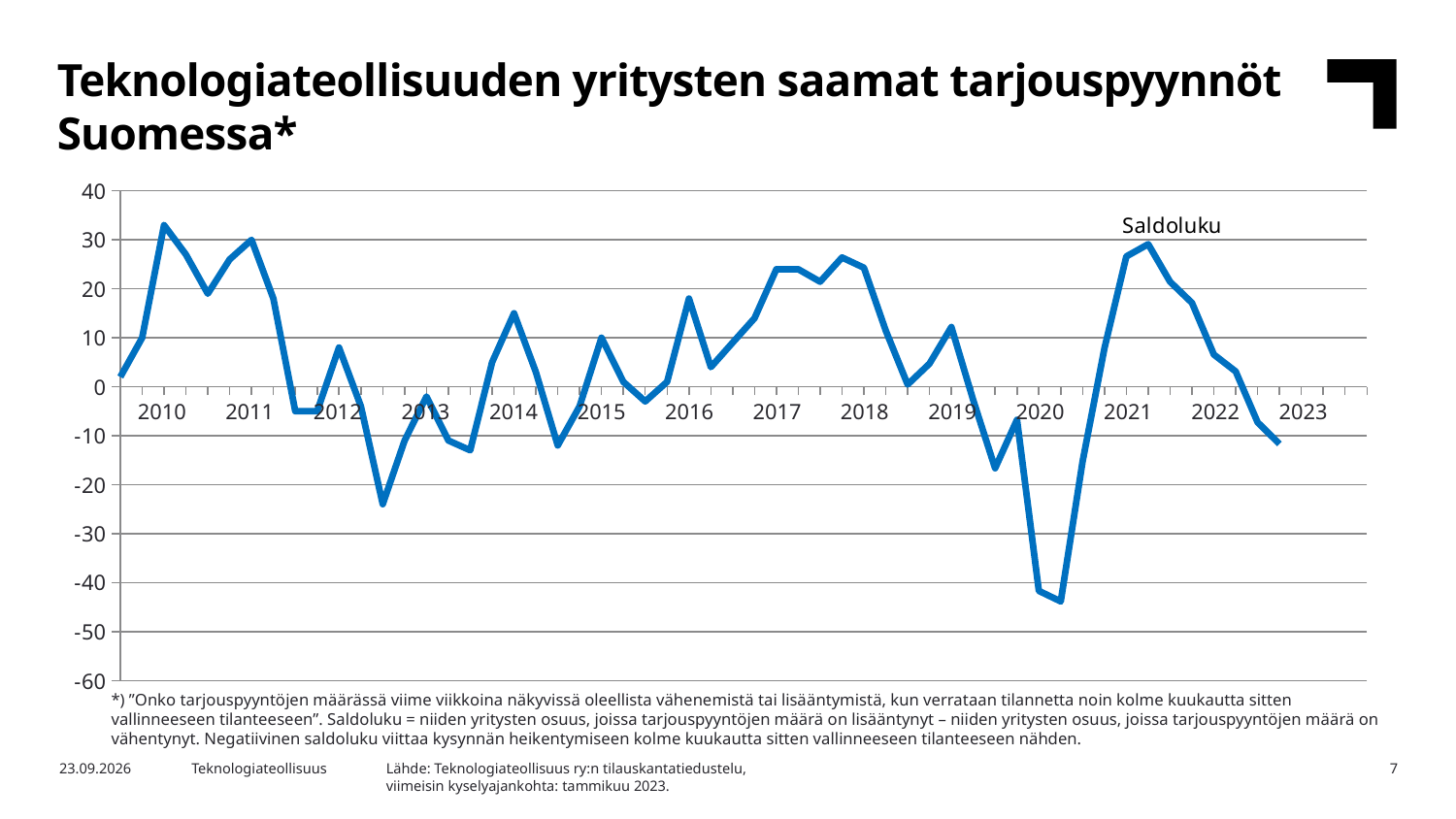
Is the peak value of the line in 2010 greater or less than 30? greater Is the lowest value of the line, reached in 2020, greater or less than -40? less Does the line rise or fall from 2021 to 2023? fall In which year does the line reach its highest value? 2010 Is the value at the start of 2023 greater or less than 0? less What kind of chart is shown on the slide? line chart What is the name of the series plotted in the chart? Saldoluku In which year does the line reach its lowest value? 2020 What is the title of the chart on the slide? Saldoluku How many years are labelled on the x axis? 14 How many series does the chart plot? 1